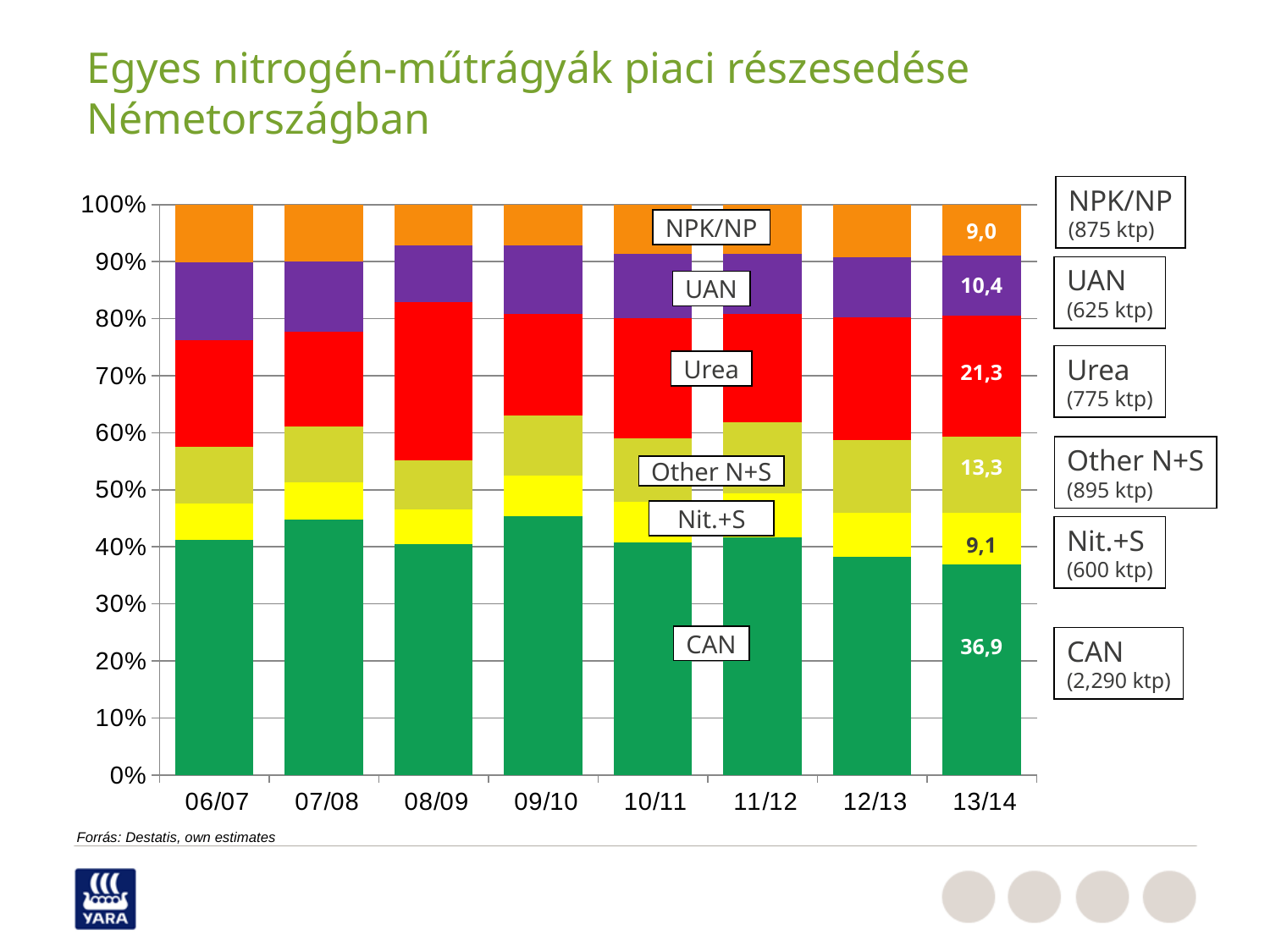
How many seasons are shown on the x axis? 8 What is the share of Urea in 13/14? 21,3 What is the share of CAN in 13/14? 36,9 What is the share of UAN in 13/14? 10,4 What is the share of Other N+S in 13/14? 13,3 Is the share of CAN in 12/13 greater or less than 40%? less Is the share of CAN in 07/08 greater or less than 40%? greater What is the difference between the CAN share and the Urea share in 13/14? 15,6 How many fertilizer types are stacked in each bar? 6 In 13/14, which is larger, the share of UAN or the share of NPK/NP? UAN What kind of chart is shown on the slide? Stacked bar chart Which fertilizer type has the largest share in 13/14? CAN